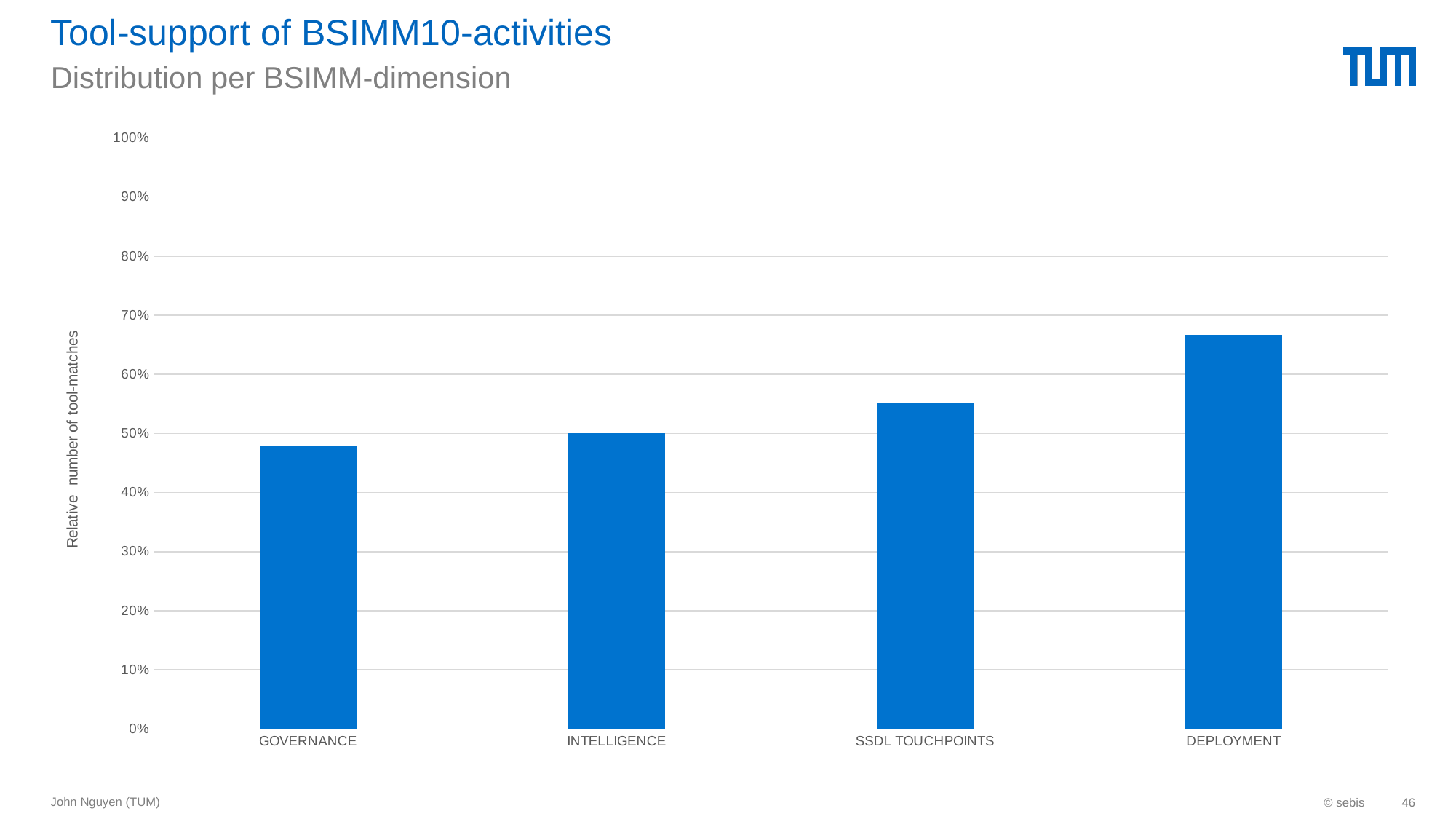
What is the label of the vertical axis? Relative number of tool-matches Which has a larger value, DEPLOYMENT or SSDL TOUCHPOINTS? DEPLOYMENT Which dimension has the lowest relative number of tool-matches? GOVERNANCE What kind of chart is shown on the slide? bar chart Is the value for GOVERNANCE greater or less than 50%? less Do the values rise or fall from left to right along the x axis? rise How many BSIMM dimensions (categories) are shown on the x axis? 4 Which has a larger value, GOVERNANCE or SSDL TOUCHPOINTS? SSDL TOUCHPOINTS Is the value for DEPLOYMENT greater or less than 60%? greater Which dimension has the highest relative number of tool-matches? DEPLOYMENT Is the value for SSDL TOUCHPOINTS greater or less than 50%? greater